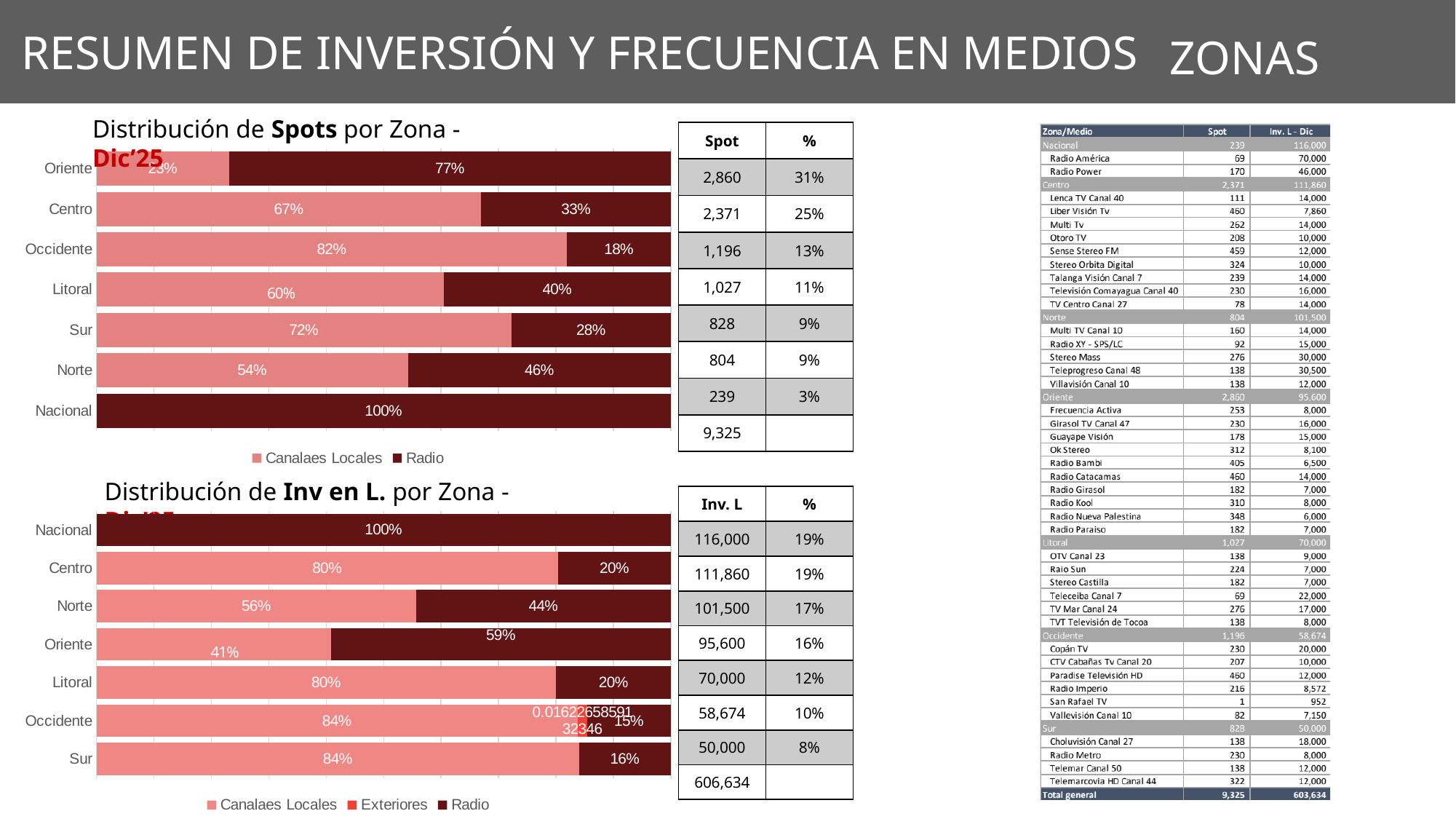
In the 'Distribución de Spots por Zona' chart, how many series does the legend list? 2 What type of chart is the 'Distribución de Spots por Zona' chart? Stacked bar chart In the 'Distribución de Spots por Zona' chart, what is the Canalaes Locales percentage for Occidente? 82% In the 'Distribución de Inv en L. por Zona' chart, what is the Radio percentage for Oriente? 59% In the 'Distribución de Inv en L. por Zona' chart, how many series does the legend list? 3 In the 'Distribución de Inv en L. por Zona' chart, how many zones are shown? 7 In the 'Distribución de Spots por Zona' chart, what is the Radio percentage for Oriente? 77% In the 'Distribución de Spots por Zona' chart, what is the difference between the Canalaes Locales percentages for Sur and Norte? 18% In the 'Distribución de Inv en L. por Zona' chart, what is the Canalaes Locales percentage for Norte? 56% In the 'Distribución de Spots por Zona' chart, which zone has the lowest Radio percentage? Occidente In the 'Distribución de Inv en L. por Zona' chart, which is larger: the Radio percentage for Norte or the Radio percentage for Litoral? Norte In the 'Distribución de Spots por Zona' chart, which zone has the highest Canalaes Locales percentage? Occidente